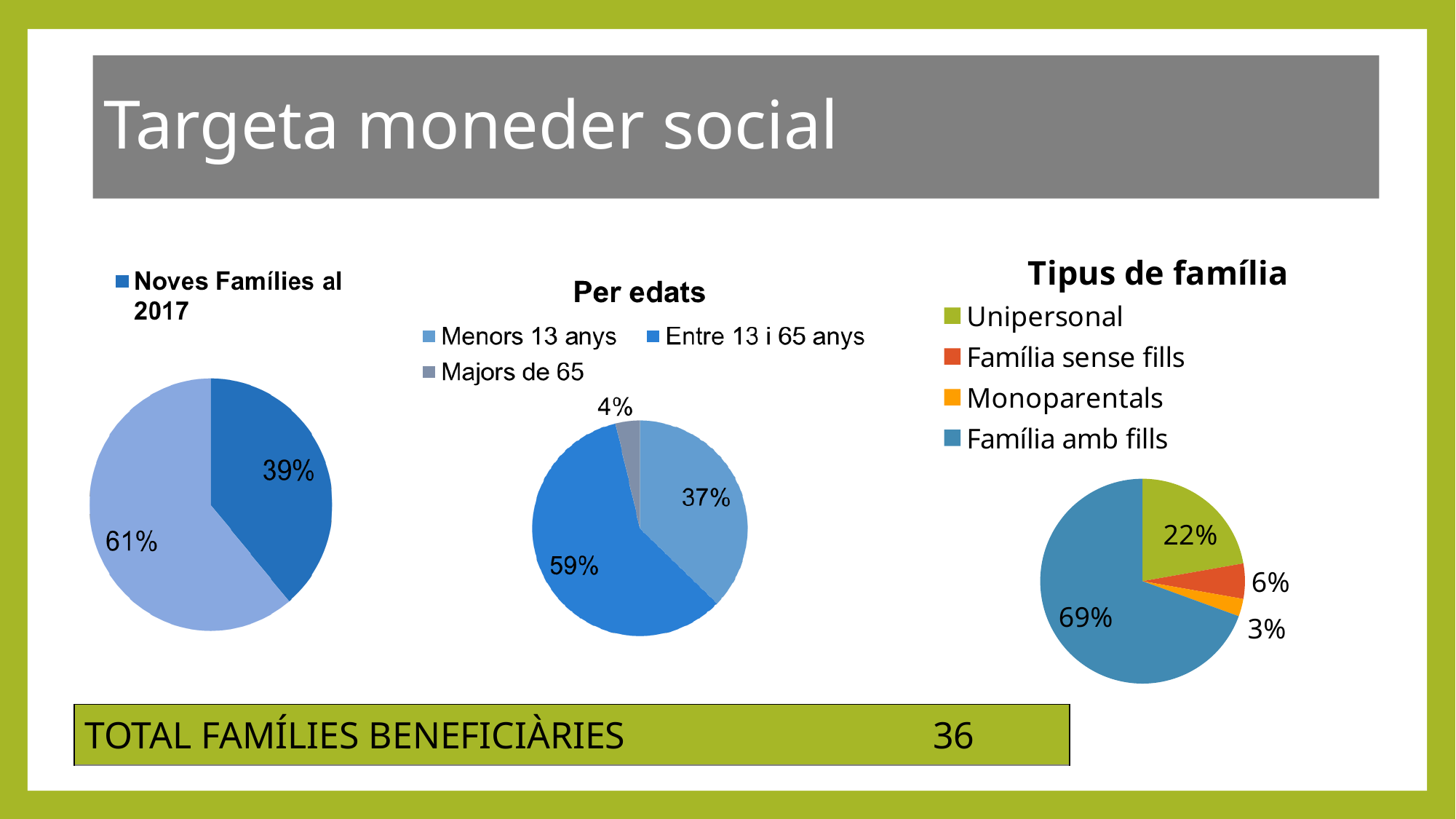
In the 'Tipus de família' chart, which is larger: 'Família sense fills' or 'Monoparentals'? Família sense fills In the 'Tipus de família' chart, which category has the largest share? Família amb fills In the 'Tipus de família' chart, which category has the smallest share? Monoparentals In the 'Tipus de família' chart, what percentage is shown for 'Unipersonal'? 22% In the leftmost chart, what percentage is shown for 'Noves Famílies al 2017'? 39% In the 'Per edats' chart, what percentage is shown for 'Entre 13 i 65 anys'? 59% In the 'Per edats' chart, what percentage is shown for 'Majors de 65'? 4% In the 'Per edats' chart, what percentage is shown for 'Menors 13 anys'? 37% What type of chart is the 'Per edats' chart? Pie chart How many categories does the legend of the 'Tipus de família' chart list? 4 In the 'Tipus de família' chart, what percentage is shown for 'Família amb fills'? 69% In the 'Per edats' chart, what is the difference in percentage points between 'Entre 13 i 65 anys' and 'Menors 13 anys'? 22